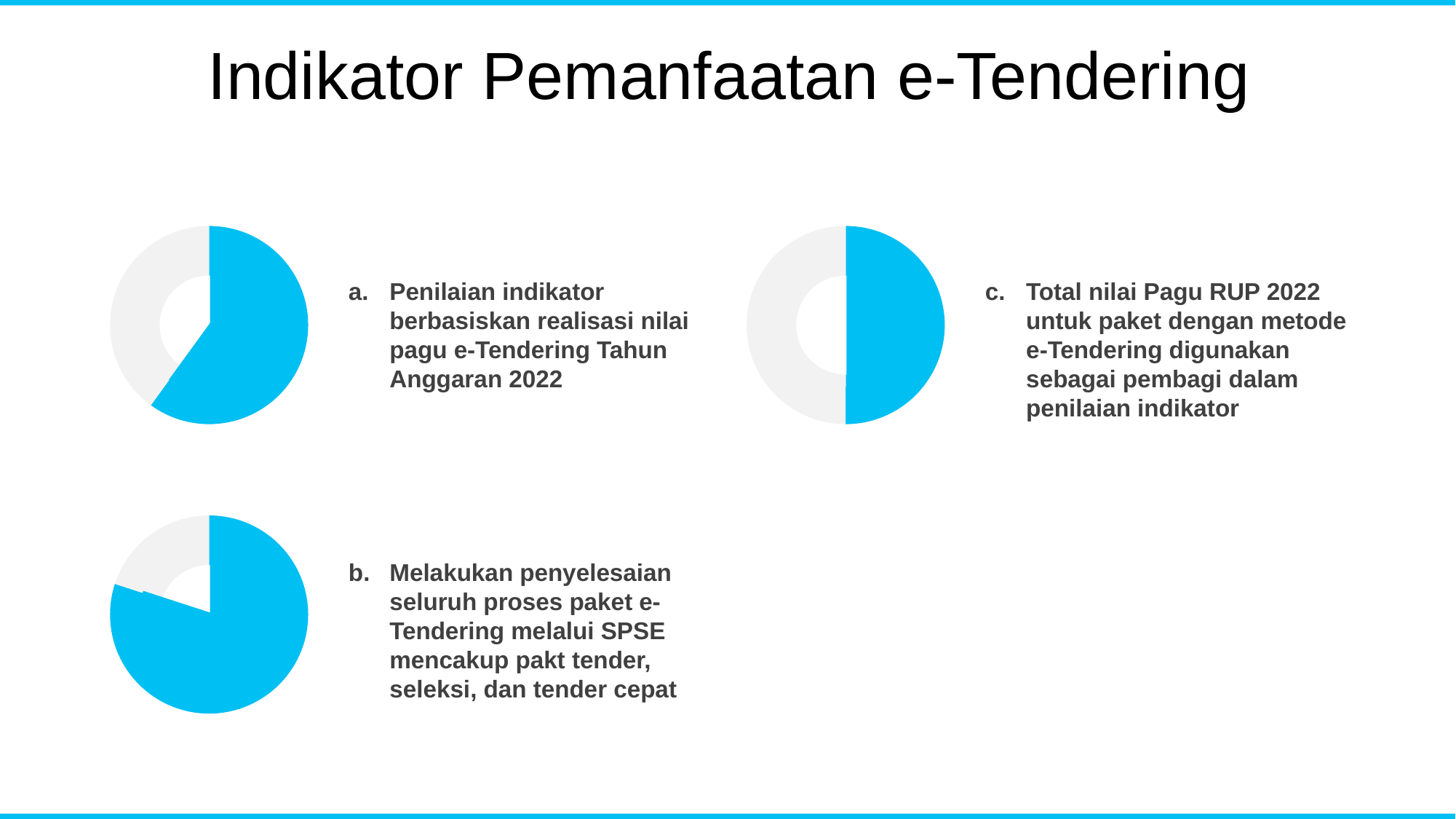
What kind of chart is shown next to item a (top left)? doughnut chart What kind of chart is shown next to item b (bottom left)? pie chart What two colours are used for the slices in the charts on the slide? blue and grey In the chart next to item b (bottom left), is the blue slice's share greater or less than 50%? greater What kind of chart is shown next to item c (top right)? doughnut chart In the chart next to item b (bottom left), how many slices are there? 2 In the chart next to item a (top left), is the grey slice's share greater or less than 50%? less In the chart next to item c (top right), how many slices are there? 2 In the chart next to item a (top left), which slice is larger, the blue one or the grey one? the blue one In the chart next to item b (bottom left), which slice is larger, the blue one or the grey one? the blue one In the chart next to item a (top left), how many slices are there? 2 How many charts are shown on the slide? 3